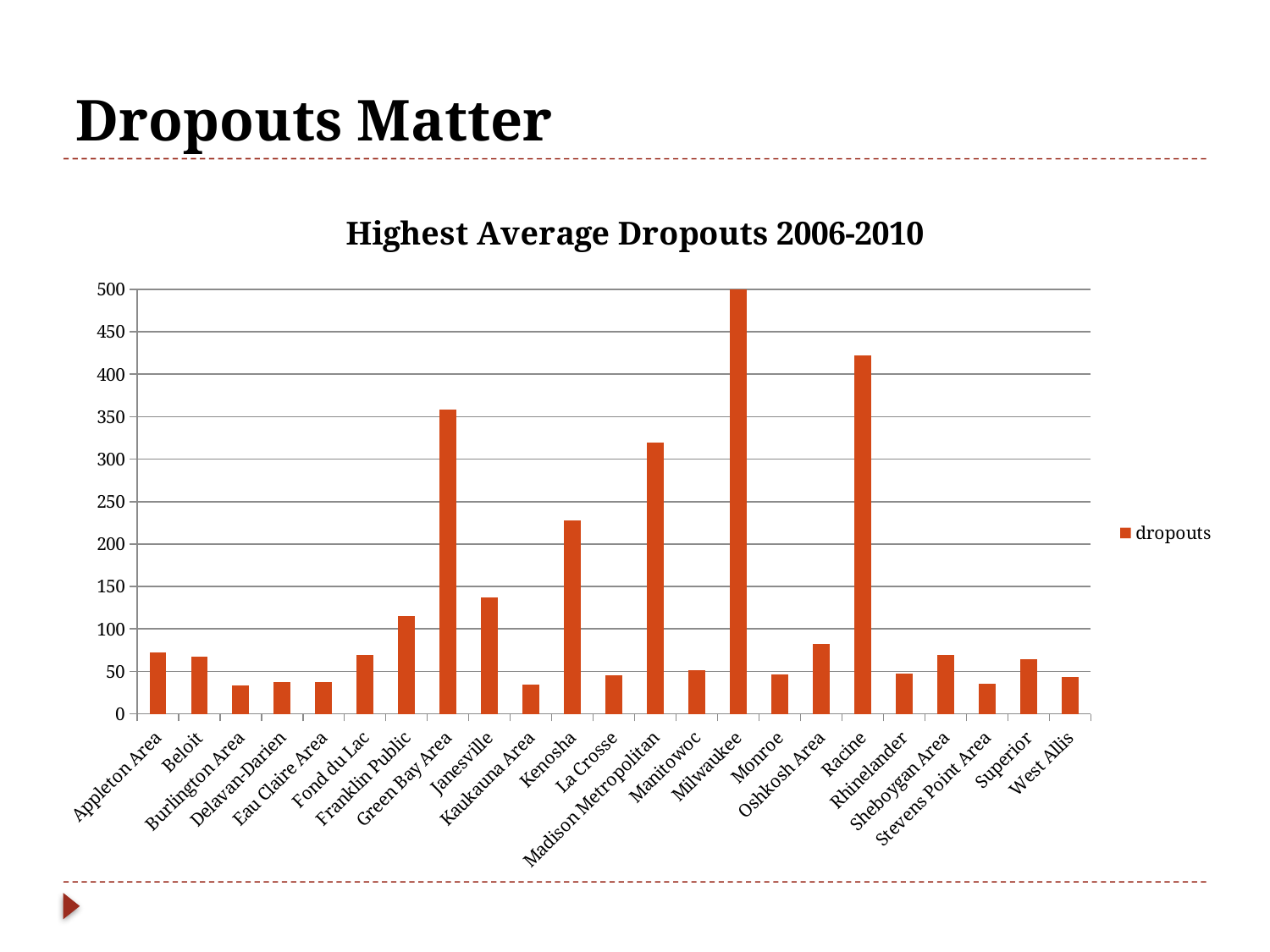
Is the value for Green Bay Area greater or less than 300? greater How many series does the legend list? 1 How many school districts (categories) are shown on the x axis? 23 Is the value for Kenosha greater or less than 200? greater Which district has the highest number of dropouts? Milwaukee Is the value for Racine greater or less than 400? greater Which has more dropouts, Madison Metropolitan or Kenosha? Madison Metropolitan Which has more dropouts, Racine or Green Bay Area? Racine What kind of chart is shown on the slide? bar chart What is the title of the chart? Highest Average Dropouts 2006-2010